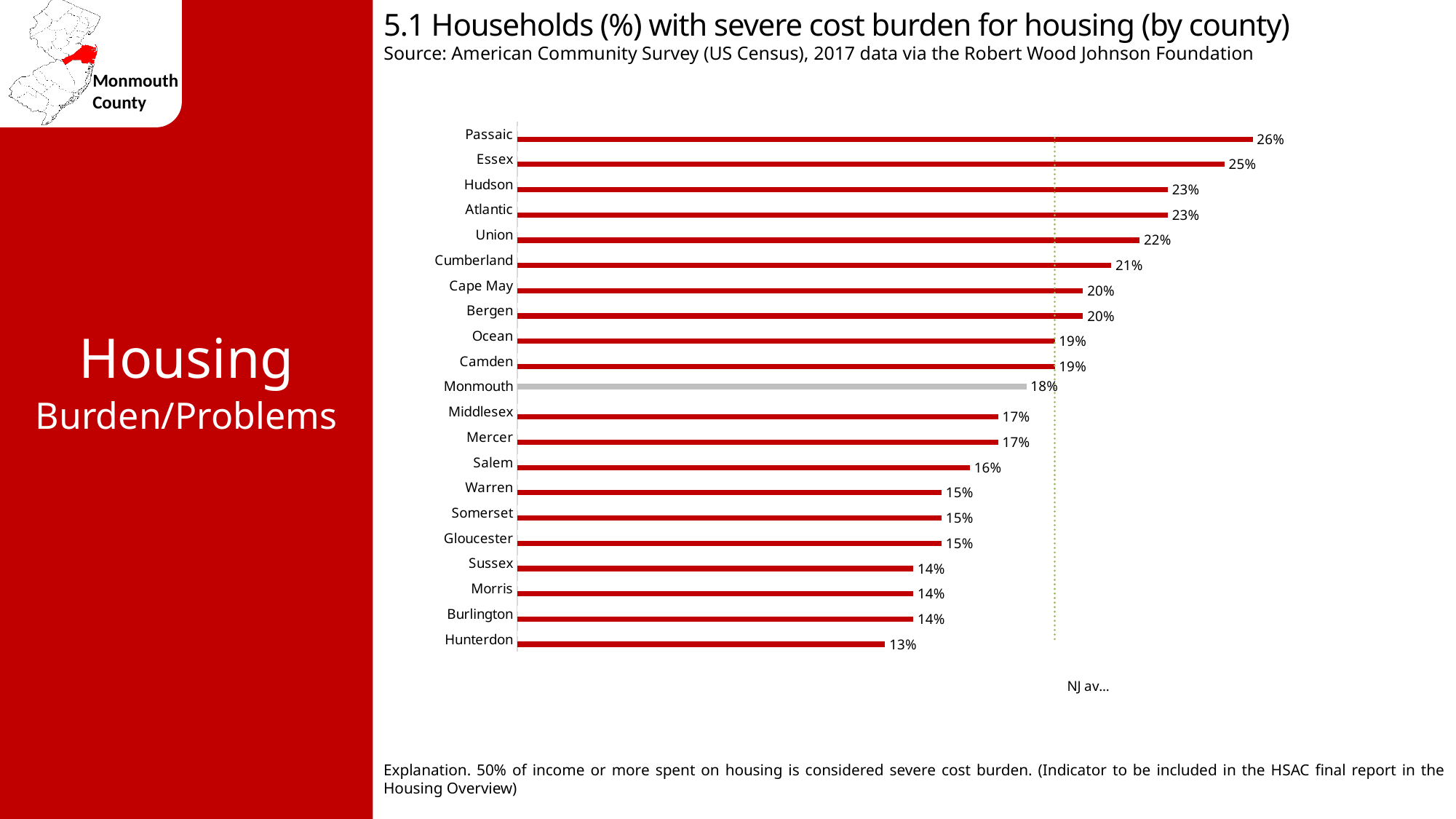
What is the value for Passaic? 26% Which county has the lowest percentage of households with severe cost burden? Hunterdon What kind of chart is shown on the slide? Bar chart Which county has the highest percentage of households with severe cost burden? Passaic What is the value for Monmouth? 18% Which county's bar is shown in grey rather than red? Monmouth What is the difference between the values for Passaic and Hunterdon? 13% How many counties are shown in the chart? 21 What is the value for Hunterdon? 13% What is the difference between the values for Essex and Monmouth? 7% What is the value for Cumberland? 21% Which is larger, the value for Union or the value for Salem? Union